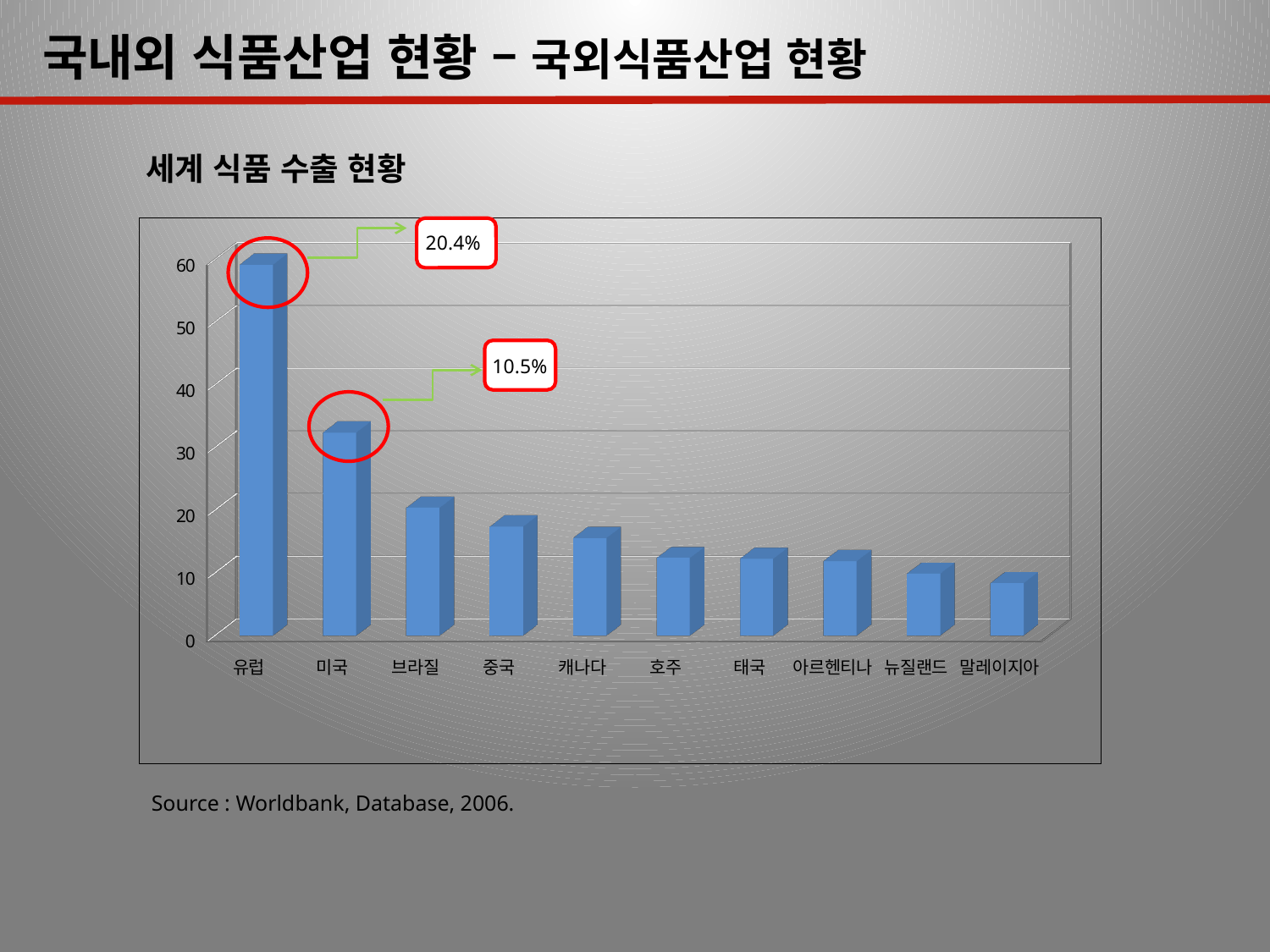
What percentage is shown in the callout pointing to the 유럽 bar? 20.4% Do the bar values rise or fall from left to right along the x axis? Fall Is the value for 미국 greater or less than 40? less Which has a higher value, 브라질 or 중국? 브라질 What kind of chart is shown on the slide? Bar chart How many countries or regions are shown on the x axis of the chart? 10 Which category has the lowest bar in the chart? 말레이지아 Is the value for 유럽 greater or less than 50? greater Which category has the highest bar in the chart? 유럽 Is the value for 브라질 greater or less than 30? less Which has a higher value, 유럽 or 미국? 유럽 Which has a higher value, 캐나다 or 호주? 캐나다